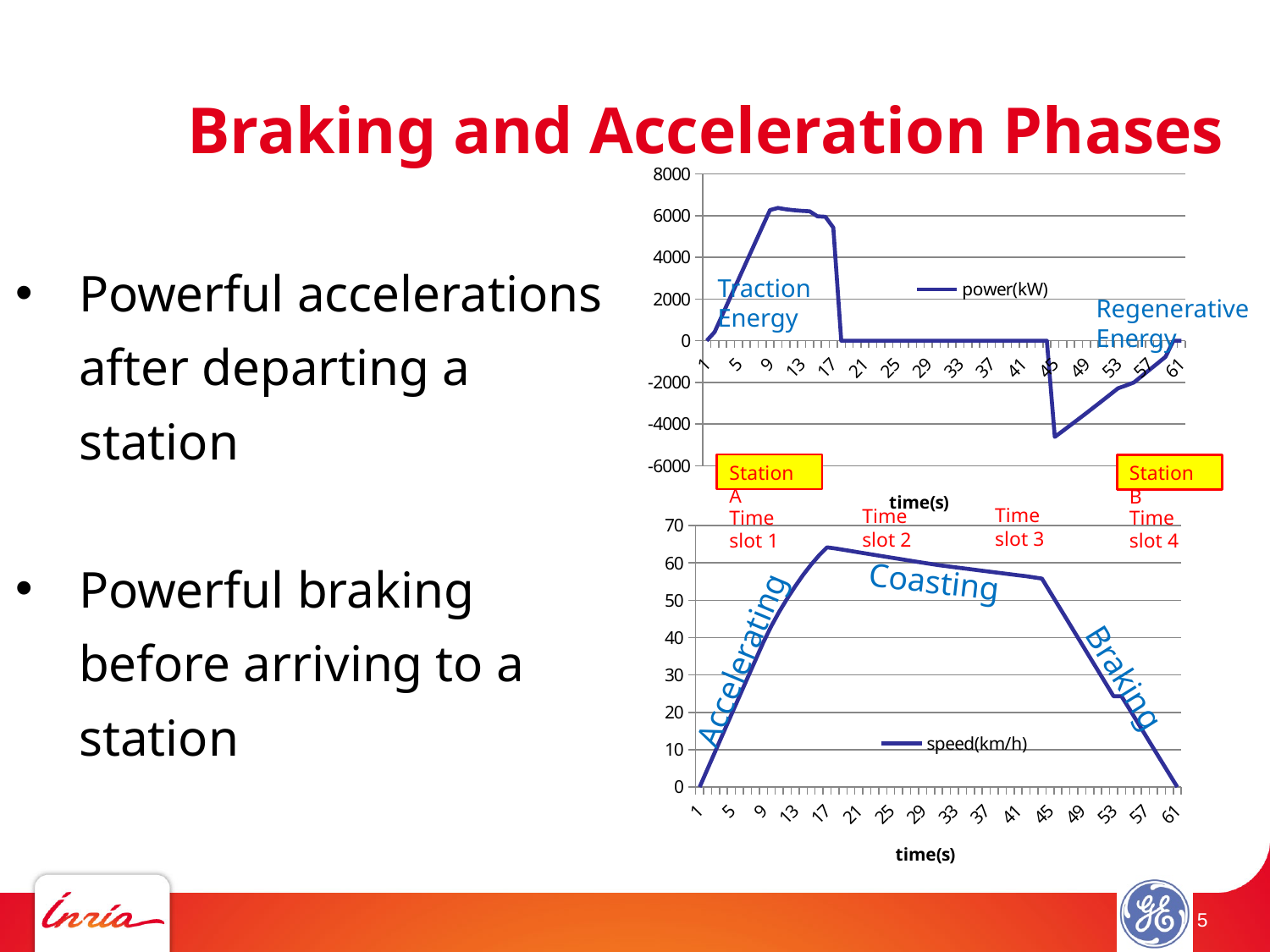
In the top chart, is the lowest value of power(kW) greater or less than -2000? less In the top chart, what is the value of power(kW) at time 25? 0 In the top chart, how many series does the legend list? 1 What kind of chart is the bottom chart showing speed(km/h)? line chart In the bottom chart, does speed(km/h) rise or fall between time 1 and time 17? rise What kind of chart is the top chart showing power(kW)? line chart In the bottom chart, what is the value of speed(km/h) at time 61? 0 In the bottom chart, does speed(km/h) rise or fall between time 45 and time 61? fall In the bottom chart, is the peak value of speed(km/h) greater or less than 50? greater In the top chart, is the peak value of power(kW) greater or less than 4000? greater In the bottom chart, what series name does the legend show? speed(km/h) In the top chart, what is the x-axis title? time(s)